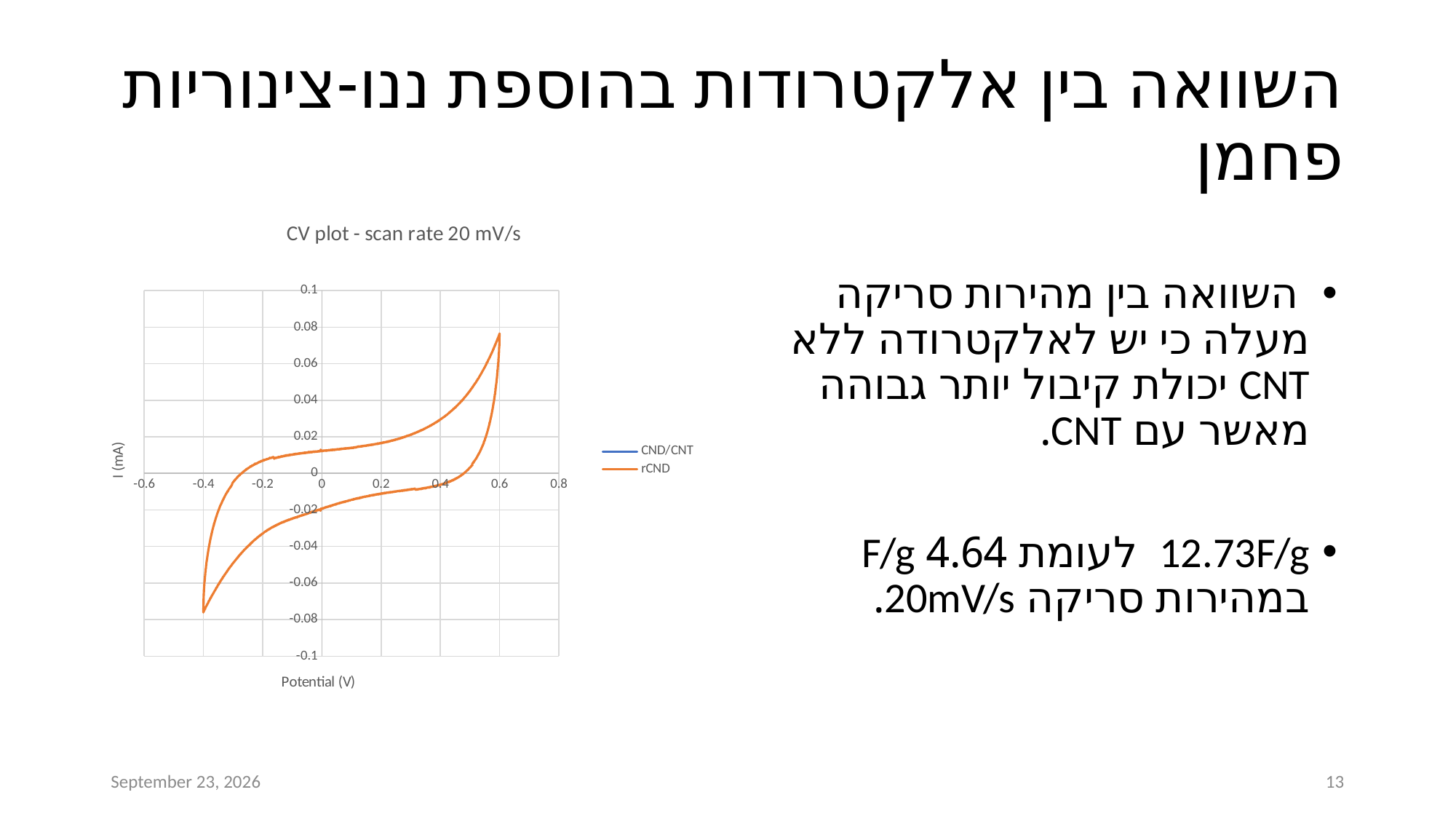
What is the lowest potential reached by the rCND curve? -0.4 What colour is the rCND series in the chart? orange Along the upper branch of the rCND curve, does the current rise or fall as the potential increases from -0.4 V to 0.6 V? rise Is the peak current of the rCND curve at 0.6 V greater or less than 0.06 mA? greater How many series does the legend of the CV plot list? 2 What is the highest potential reached by the rCND curve? 0.6 Is the lowest current of the rCND curve at -0.4 V greater or less than -0.06 mA? less On the upper branch of the rCND curve, is the current at 0 V greater or less than 0.02 mA? less What kind of chart is shown on the slide? line chart What is the title of the chart? CV plot - scan rate 20 mV/s